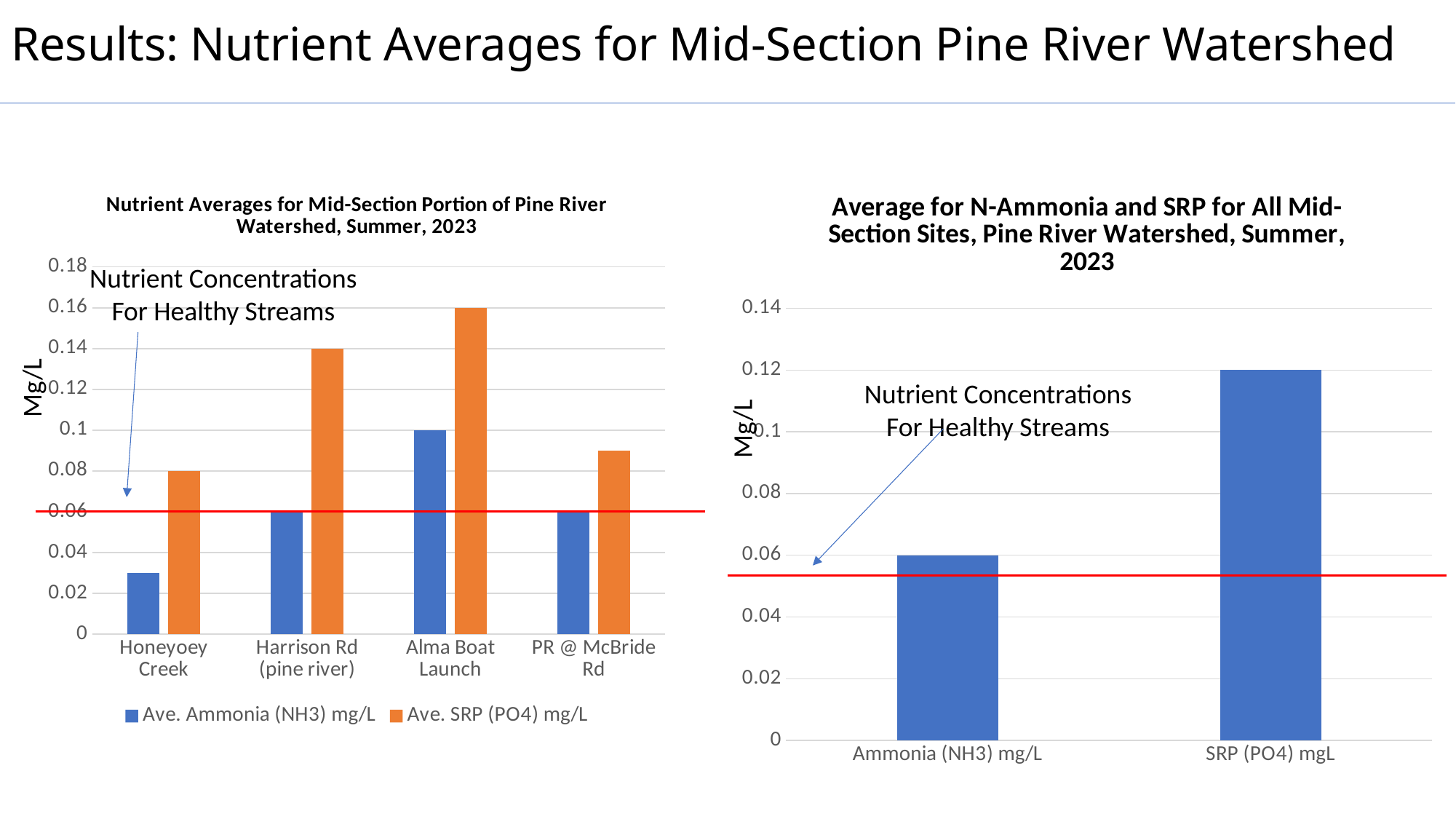
In the right chart titled 'Average for N-Ammonia and SRP for All Mid-Section Sites', what is the value for SRP (PO4) mgL? 0.12 What kind of chart is the left chart titled 'Nutrient Averages for Mid-Section Portion of Pine River Watershed, Summer, 2023'? Bar chart In the left chart, which site has the highest Ave. SRP (PO4) mg/L value? Alma Boat Launch In the left chart, how many series does the legend list? 2 In the left chart, is the Ave. Ammonia (NH3) mg/L value for Honeyoey Creek greater or less than 0.04? less In the left chart, which site has the larger Ave. SRP (PO4) mg/L value, Harrison Rd (pine river) or PR @ McBride Rd? Harrison Rd (pine river) In the left chart, what is the Ave. Ammonia (NH3) mg/L value for Alma Boat Launch? 0.1 In the left chart, what is the Ave. SRP (PO4) mg/L value for Alma Boat Launch? 0.16 In the left chart, which site has the lowest Ave. Ammonia (NH3) mg/L value? Honeyoey Creek In the left chart, what is the Ave. SRP (PO4) mg/L value for Harrison Rd (pine river)? 0.14 In the left chart, how many sampling sites are shown on the x axis? 4 In the right chart, what is the difference between the SRP (PO4) mgL value and the Ammonia (NH3) mg/L value? 0.06